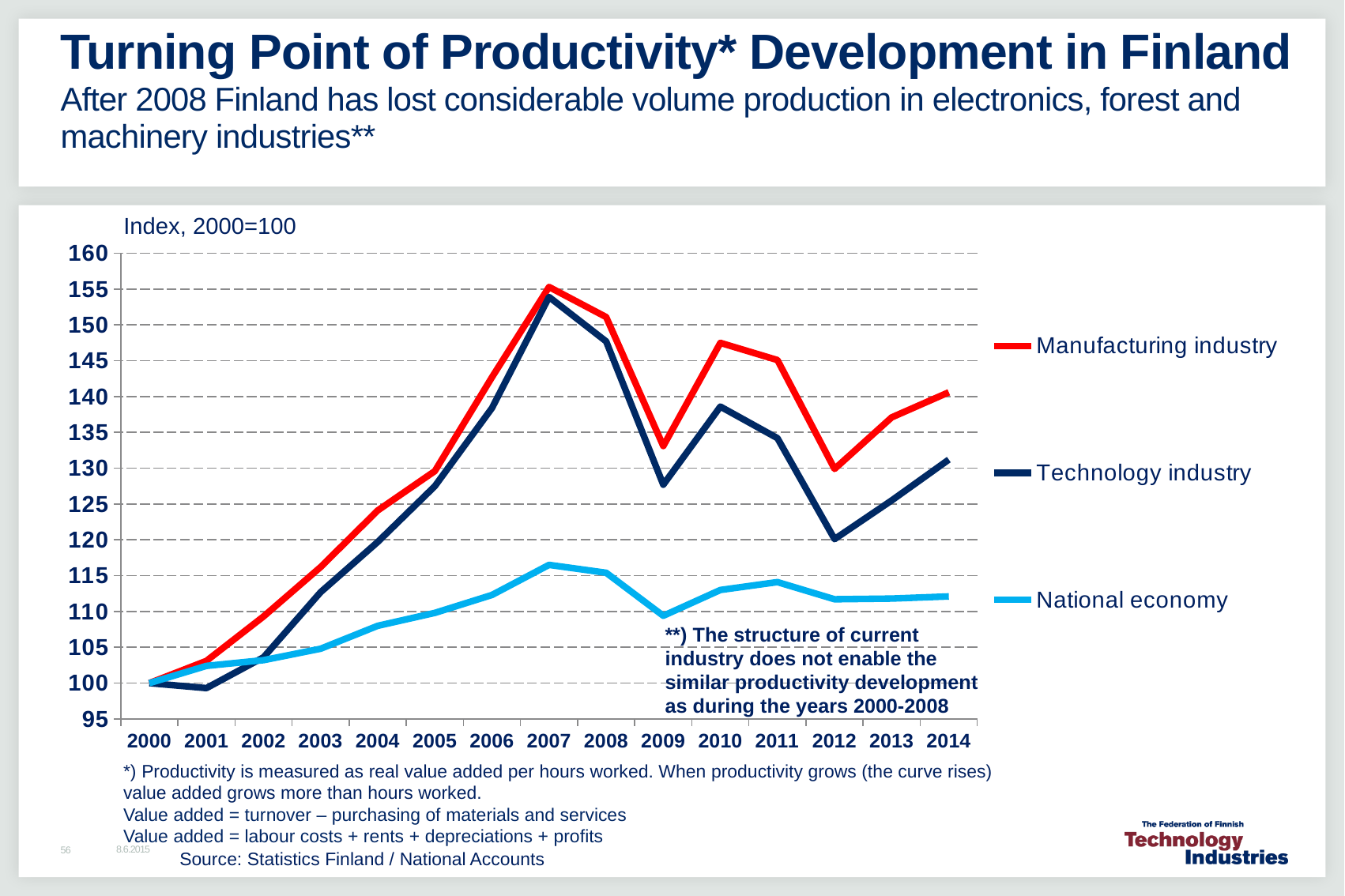
In 2010, which is higher: Manufacturing industry or National economy? Manufacturing industry In which year does the Manufacturing industry line reach its highest value? 2007 Is the value for Manufacturing industry in 2009 greater or less than 135? less Does the Technology industry line rise or fall from 2012 to 2014? rise What is the index base stated above the chart? Index, 2000=100 Is the value for Technology industry in 2009 greater or less than 125? greater Is the value for National economy in 2007 greater or less than 120? less How many years are plotted along the x axis? 15 How many series does the legend list? 3 What kind of chart is shown on the slide? line chart Which series has the lowest value in 2014? National economy